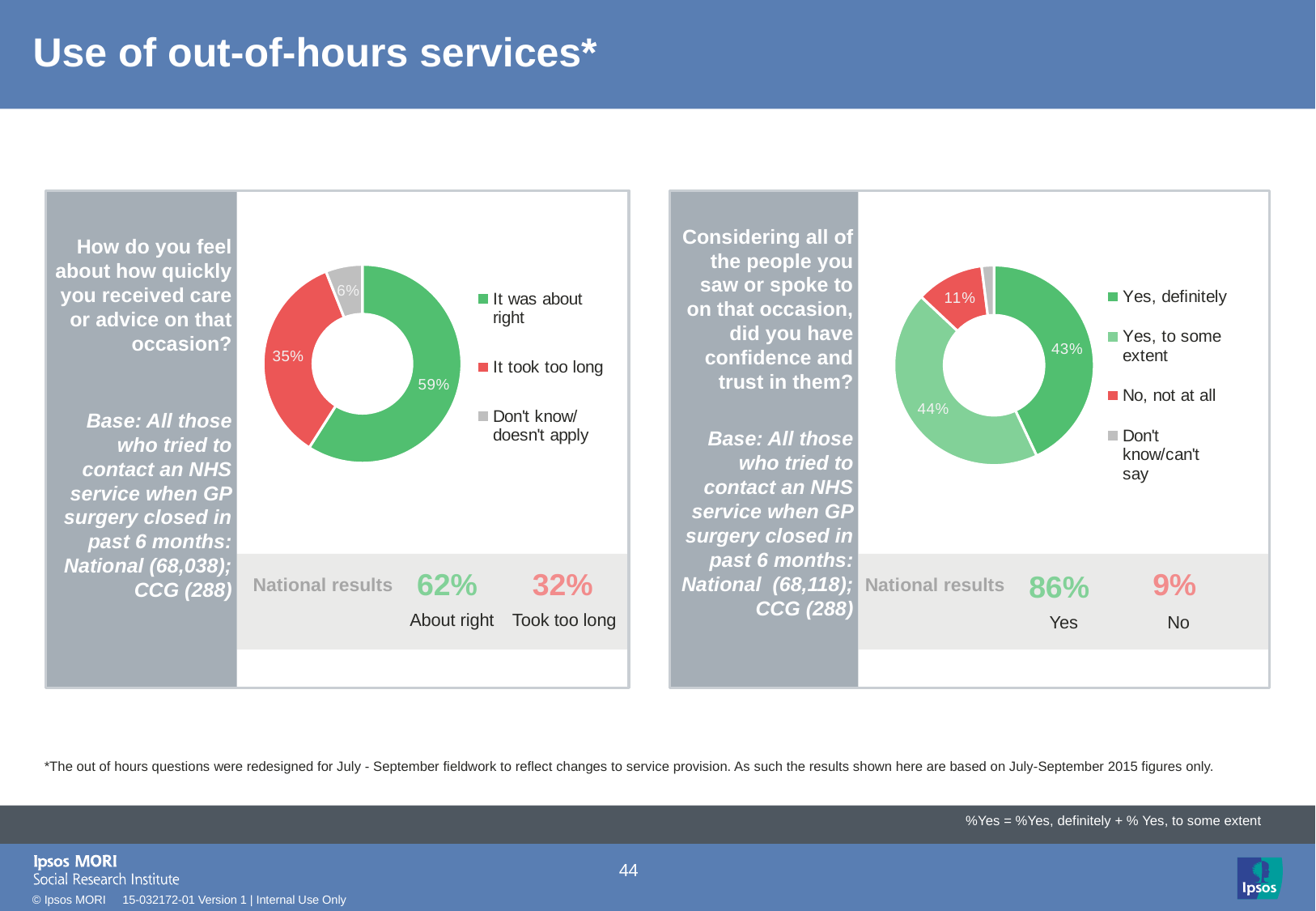
In the left chart about how quickly care or advice was received, what percentage said it was about right? 59% In the right chart about confidence and trust, what percentage said 'No, not at all'? 11% In the left chart about how quickly care or advice was received, what is the difference between 'It was about right' and 'It took too long'? 24 percentage points In the left chart about how quickly care or advice was received, which response has the largest share? It was about right In the right chart about confidence and trust, which response has the smallest share? Don't know/can't say In the left chart about how quickly care or advice was received, what percentage said it took too long? 35% What type of chart is used on the left to show how people feel about how quickly they received care? Pie (donut) chart In the right chart about confidence and trust, how many categories does the legend list? 4 In the left chart about how quickly care or advice was received, what percentage answered don't know/doesn't apply? 6% In the left chart about how quickly care or advice was received, what colour represents 'It took too long'? Red In the right chart about confidence and trust, what percentage said 'Yes, to some extent'? 44% In the right chart about confidence and trust, what percentage said 'Yes, definitely'? 43%